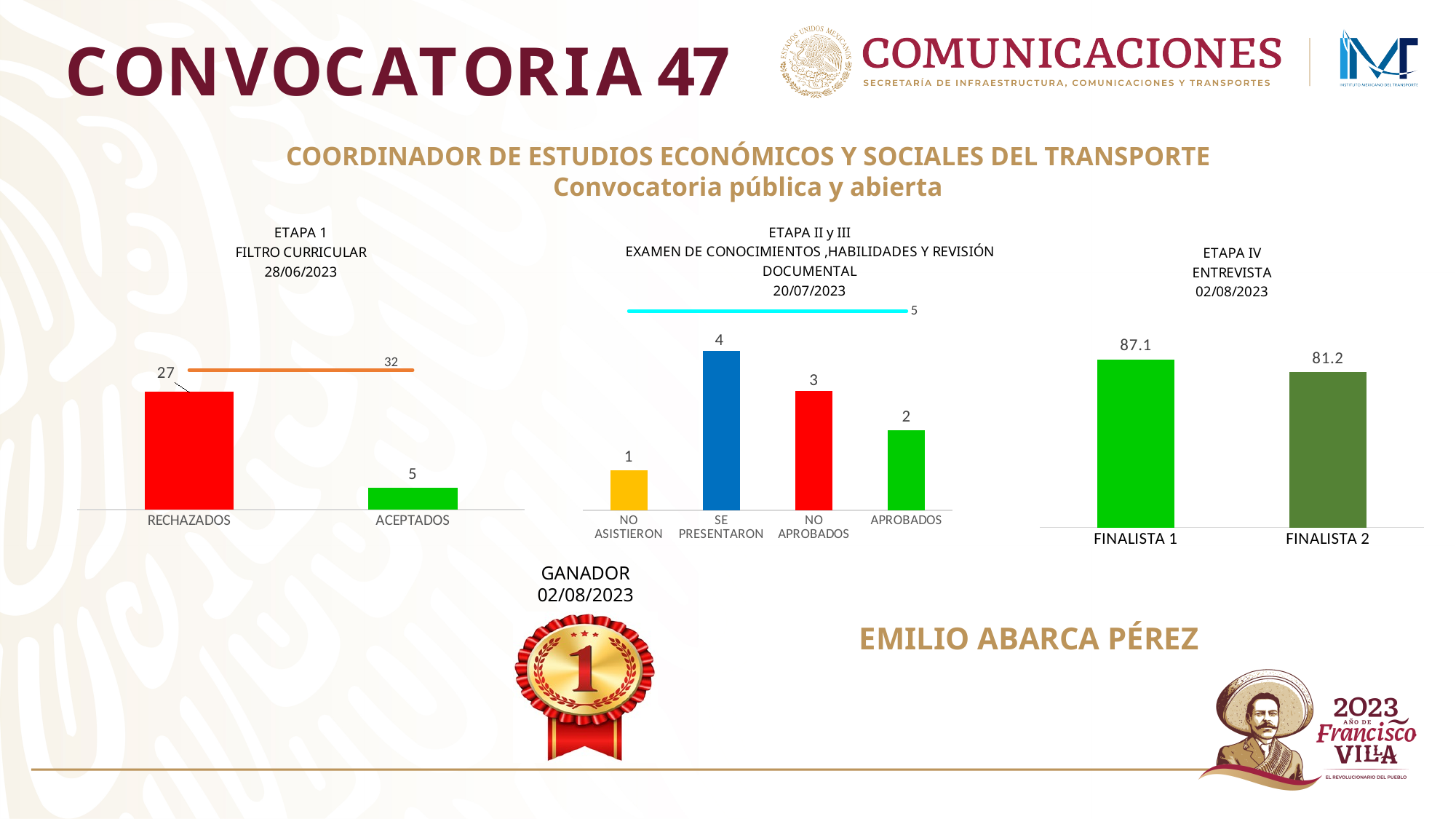
In the ETAPA II y III chart, which category has the highest value? SE PRESENTARON In the ETAPA IV ENTREVISTA chart, which is larger, FINALISTA 1 or FINALISTA 2? FINALISTA 1 In the ETAPA IV ENTREVISTA chart, what is the value for FINALISTA 1? 87.1 In the ETAPA II y III chart, what is the value for SE PRESENTARON? 4 In the ETAPA 1 FILTRO CURRICULAR chart, what is the difference between RECHAZADOS and ACEPTADOS? 22 How many categories are shown in the ETAPA II y III chart? 4 What kind of chart is the ETAPA IV ENTREVISTA chart? Bar chart In the ETAPA 1 FILTRO CURRICULAR chart, what is the value for ACEPTADOS? 5 In the ETAPA 1 FILTRO CURRICULAR chart, what is the value for RECHAZADOS? 27 In the ETAPA II y III chart, which category has the lowest value? NO ASISTIERON In the ETAPA 1 FILTRO CURRICULAR chart, what value is labelled on the horizontal orange line? 32 In the ETAPA II y III chart, what is the value for NO ASISTIERON? 1